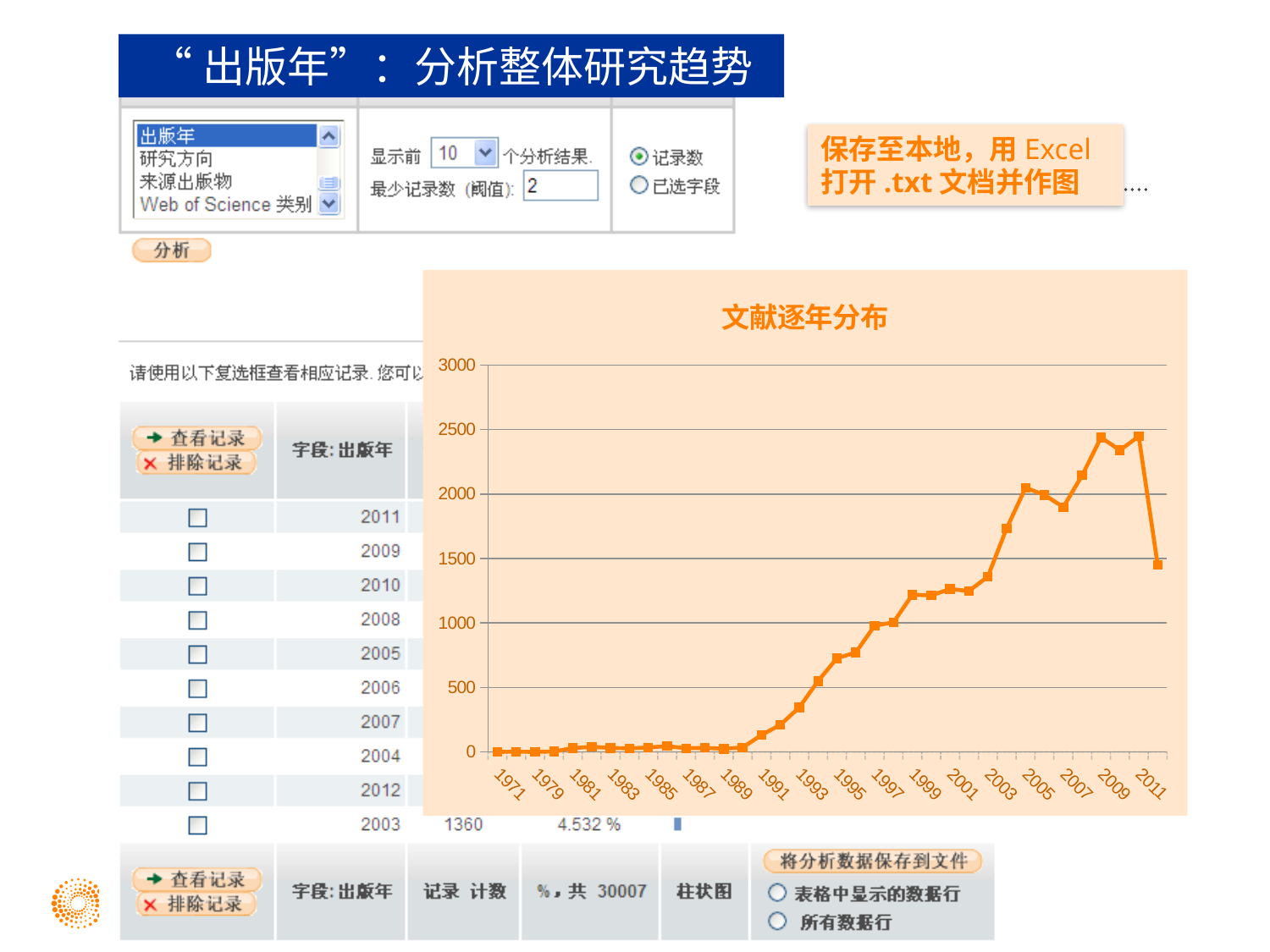
What is the title of the chart on the slide? 文献逐年分布 Is the value for 2011 greater or less than 2000? greater Overall, do the values in the chart rise or fall from 1971 to 2009? rise Is the value for 2009 greater or less than 2000? greater Is the value for 1999 greater or less than 1000? greater What is the highest value shown on the chart's vertical axis? 3000 What kind of chart is shown on the slide? line chart Which year has the larger value, 1991 or 2001? 2001